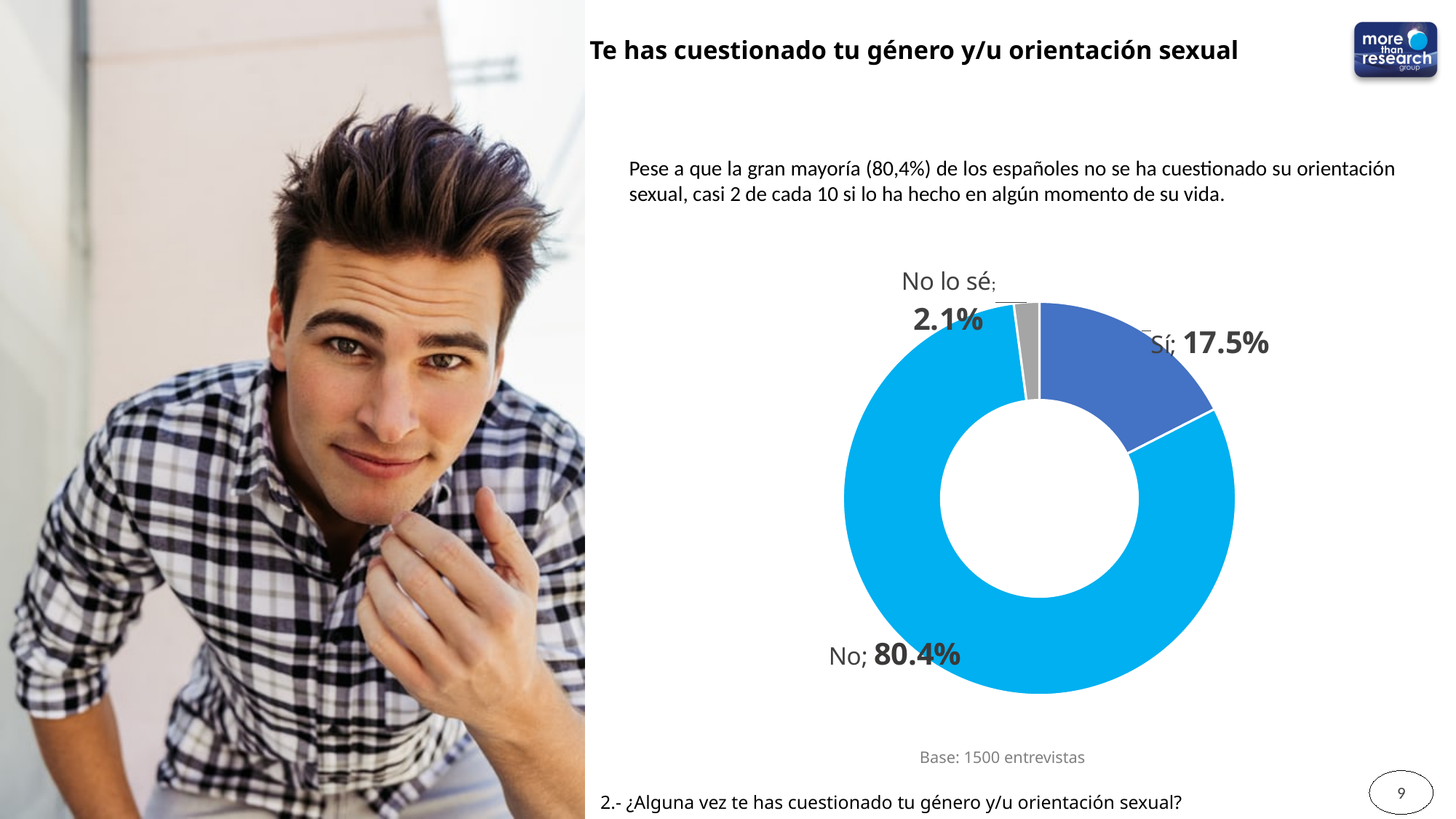
Which is larger, the "Sí" slice or the "No lo sé" slice? Sí What percentage of respondents answered "No lo sé"? 2.1% Which response has the smallest share of the chart? No lo sé What is the combined share of the "Sí" and "No lo sé" slices? 19.6% What is the difference in percentage points between the "No" and "Sí" slices? 62.9 What percentage of respondents answered "Sí"? 17.5% How many slices does the chart have? 3 What kind of chart is shown on the slide? Doughnut (pie) chart Which response has the largest share of the chart? No What colour is the "No" slice of the chart? Light blue What is the base (number of interviews) stated below the chart? 1500 entrevistas What percentage of respondents answered "No"? 80.4%